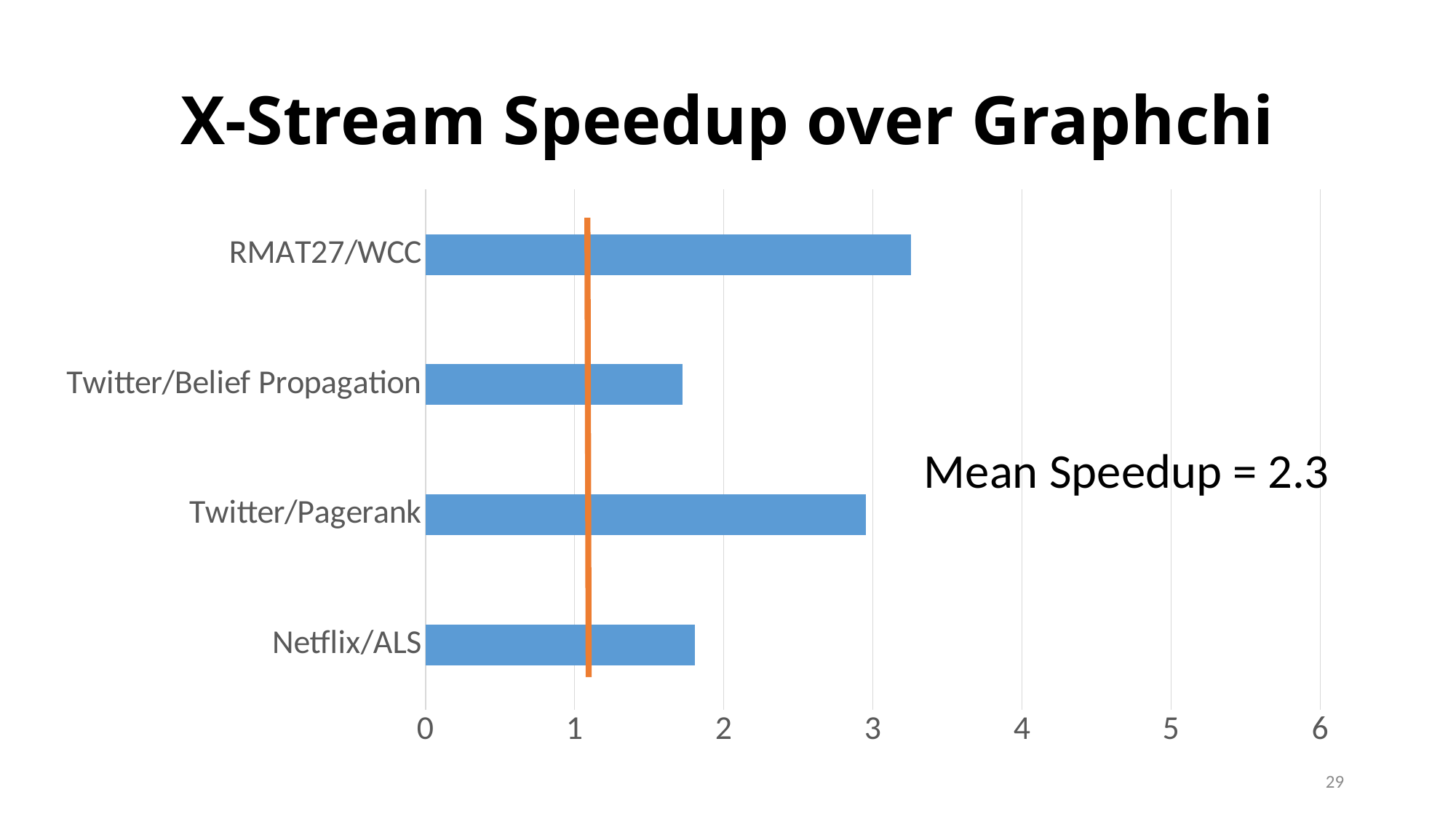
Is the value for RMAT27/WCC greater or less than 3? greater Is the value for Netflix/ALS greater or less than 1? greater Is the value for Twitter/Belief Propagation greater or less than 2? less What kind of chart is shown on the slide? bar chart Which is larger, the speedup for RMAT27/WCC or for Twitter/Pagerank? RMAT27/WCC Which category has the highest speedup in the chart? RMAT27/WCC What is the title of the chart? X-Stream Speedup over Graphchi How many categories are plotted in the chart? 4 What mean speedup is stated on the slide? 2.3 Which is larger, the speedup for Twitter/Pagerank or for Twitter/Belief Propagation? Twitter/Pagerank